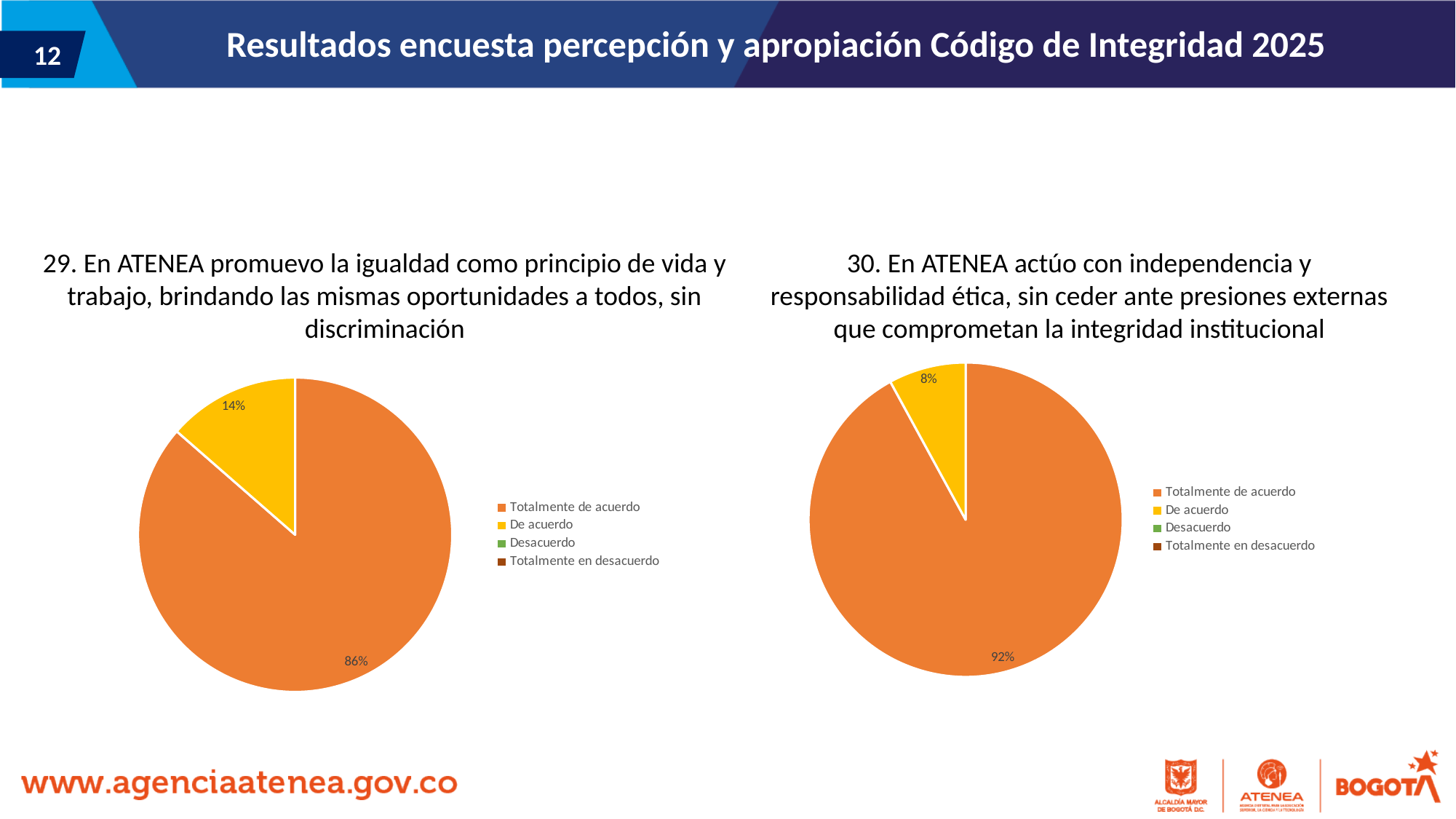
In the right pie chart (question 30), which category has the largest share? Totalmente de acuerdo In the right pie chart (question 30), what share of responses is 'De acuerdo'? 8% What type of chart is used for question 29 on the left? Pie chart Which chart has the larger 'De acuerdo' share, the left pie chart (question 29) or the right pie chart (question 30)? The left pie chart (question 29) In the right pie chart (question 30), what is the difference between the 'Totalmente de acuerdo' and 'De acuerdo' shares? 84% In the left pie chart (question 29), what share of responses is 'De acuerdo'? 14% In the right pie chart (question 30), what share of responses is 'Totalmente de acuerdo'? 92% In the left pie chart (question 29), what is the difference between the 'Totalmente de acuerdo' and 'De acuerdo' shares? 72% In the left pie chart (question 29), what colour represents 'De acuerdo'? Yellow In the left pie chart (question 29), which category has the largest share? Totalmente de acuerdo In the left pie chart (question 29), what share of responses is 'Totalmente de acuerdo'? 86% How many entries does the legend of the right pie chart (question 30) list? 4